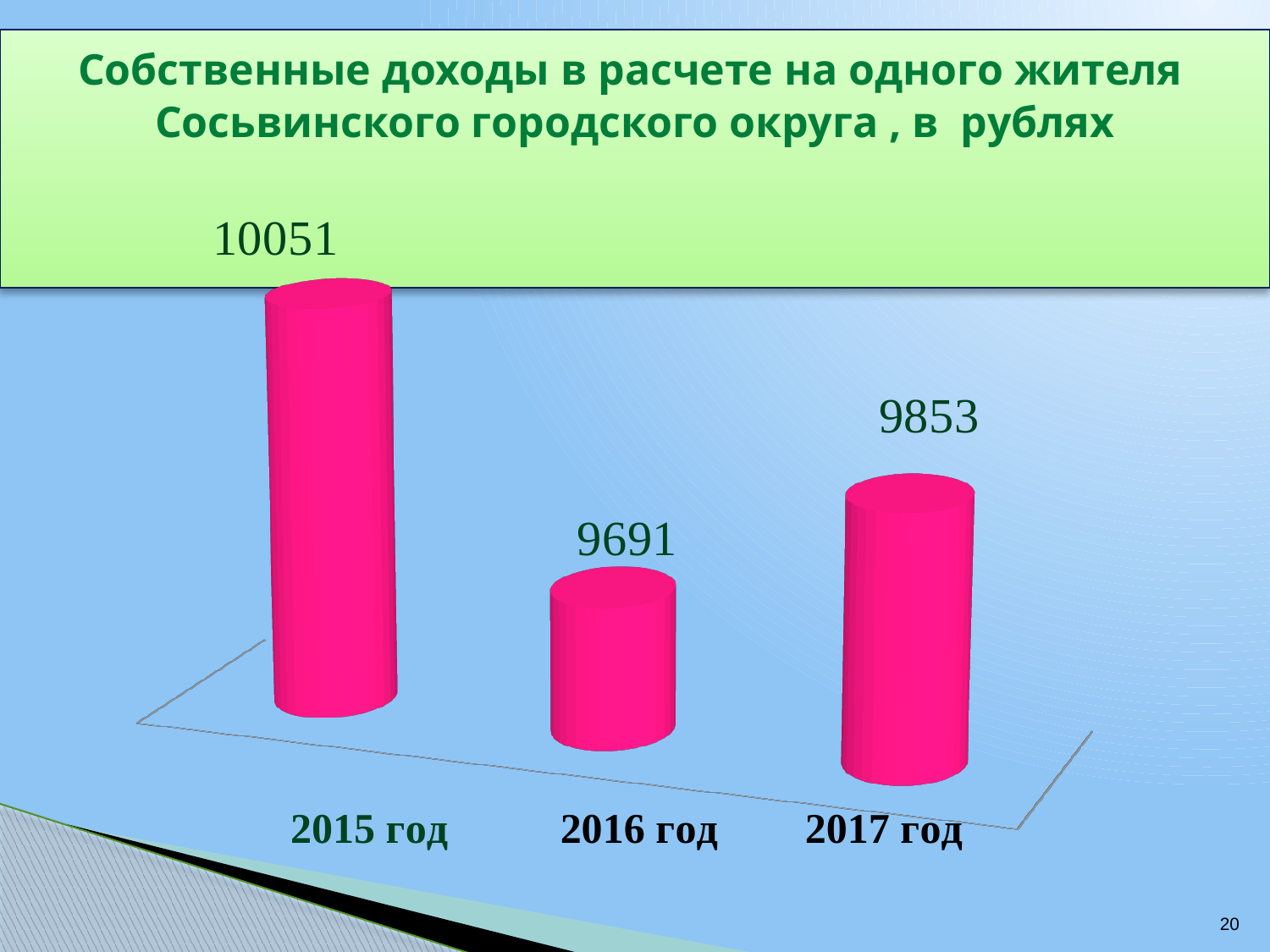
What is the difference between the values for 2015 год and 2016 год? 360 What is the value for 2015 год? 10051 What is the title of the chart? Собственные доходы в расчете на одного жителя Сосьвинского городского округа , в рублях Which is larger, the value for 2015 год or the value for 2017 год? 2015 год Which year has the highest value? 2015 год How many years are shown in the chart? 3 What is the difference between the values for 2017 год and 2016 год? 162 Which year has the lowest value? 2016 год What kind of chart is shown on the slide? bar chart Does the value rise or fall from 2015 год to 2016 год? fall What is the value for 2016 год? 9691 What is the value for 2017 год? 9853